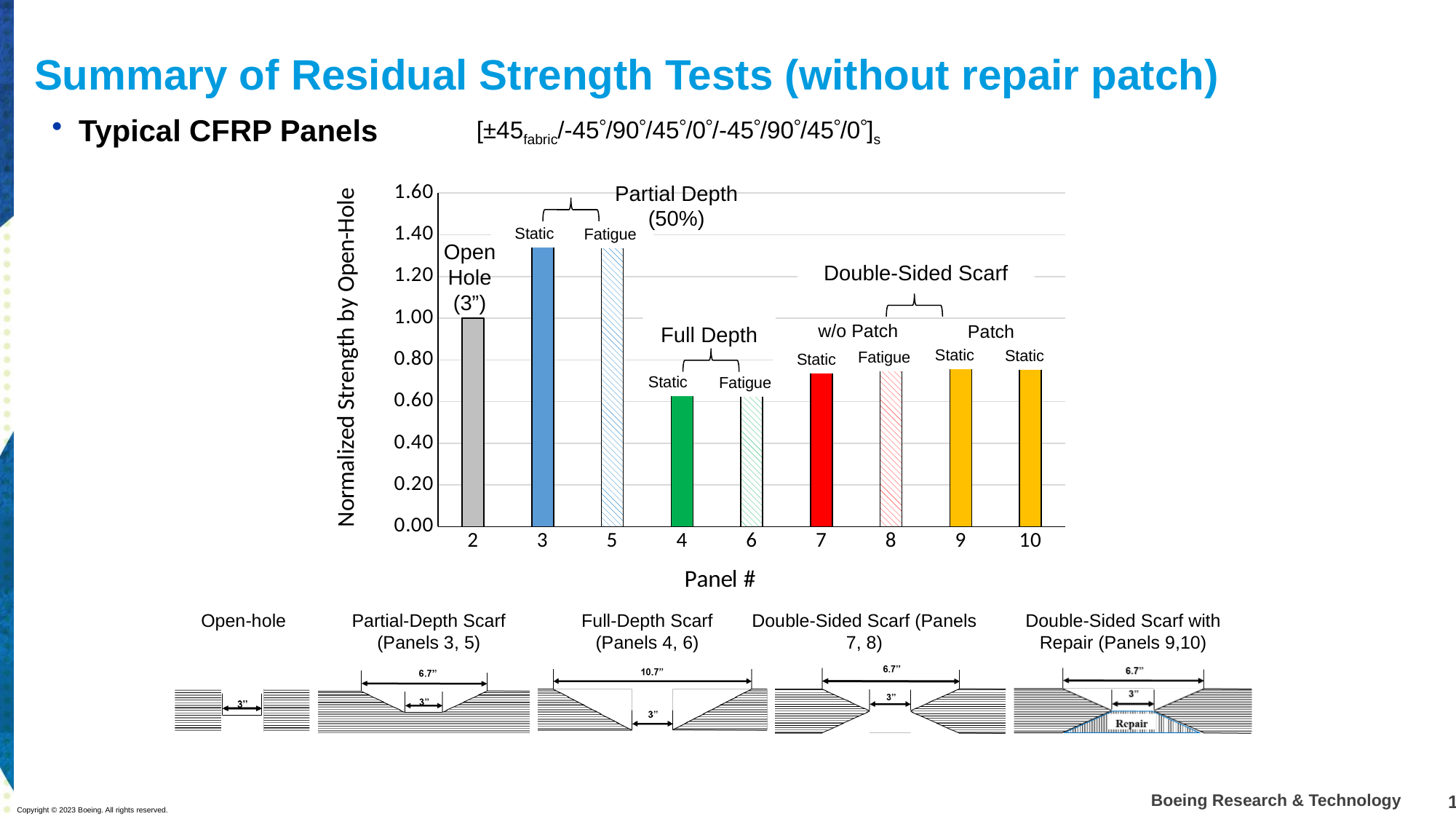
Is the value for Panel 3 greater or less than 1.20? greater Is the value for Panel 4 greater or less than 0.80? less Is the value for Panel 5 greater or less than 1.00? greater Which has a higher normalized strength, Panel 3 or Panel 4? Panel 3 What is the title of the x axis of the chart? Panel # How many panels (bars) are plotted in the chart? 9 Which has a higher normalized strength, Panel 2 or Panel 7? Panel 2 What kind of chart is shown on the slide? bar chart What is the normalized strength value for Panel 2 (Open Hole)? 1.00 What is the title of the y axis of the chart? Normalized Strength by Open-Hole